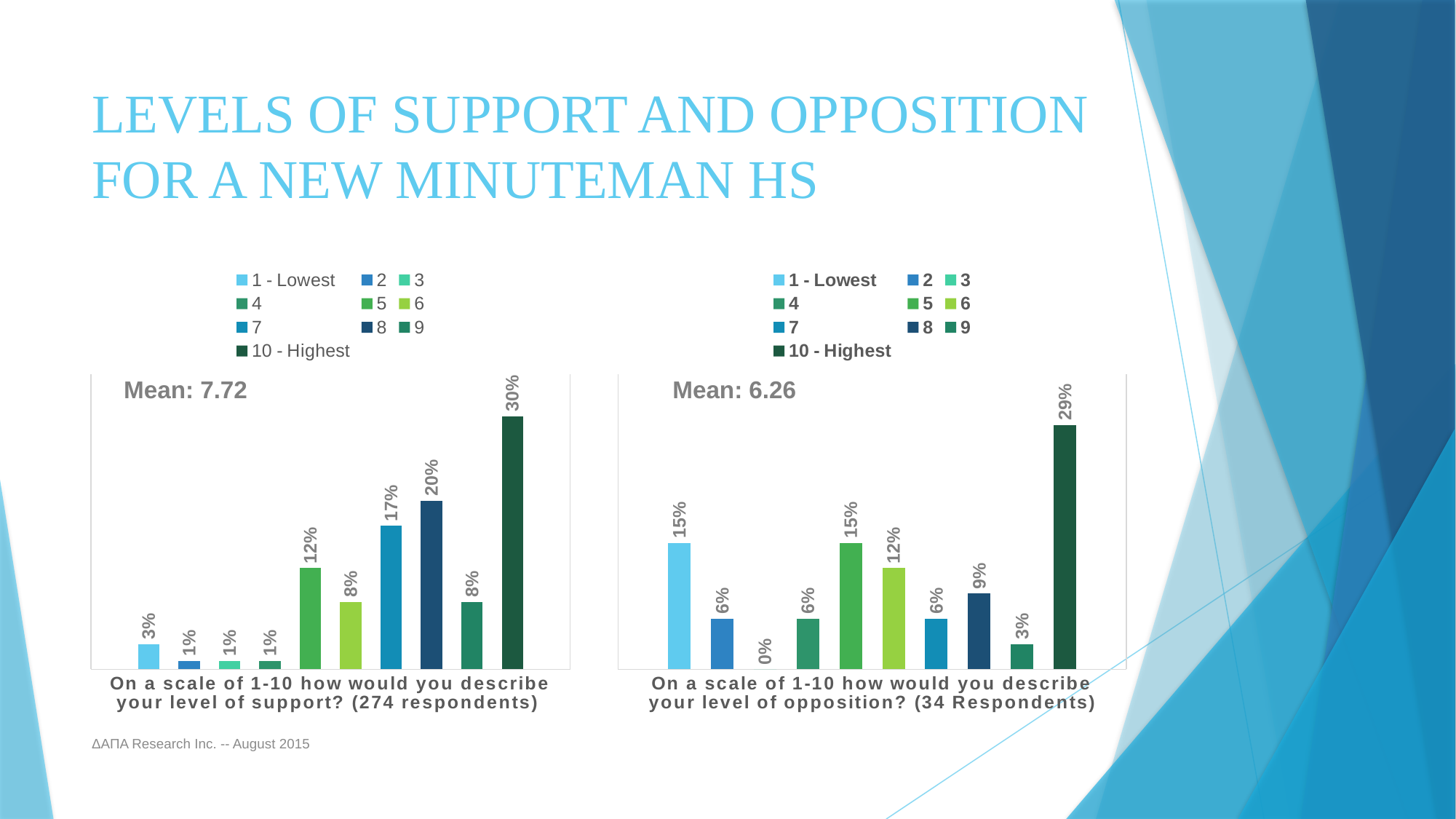
In the right chart (level of opposition), which is larger: the percentage for rating 6 or the percentage for rating 8? 6 In the left chart (level of support), what percentage of respondents gave a rating of 10 - Highest? 30% How many respondents does the right chart (level of opposition) report? 34 How many series does the legend of the left chart (level of support) list? 10 In the right chart (level of opposition), what is the difference between the percentage for rating 10 - Highest and the percentage for rating 5? 14% In the right chart (level of opposition), which rating has the highest percentage? 10 - Highest In the right chart (level of opposition), what percentage of respondents gave a rating of 1 - Lowest? 15% In the left chart (level of support), what is the difference between the percentage for rating 8 and the percentage for rating 6? 12% What is the mean shown on the left chart (level of support)? 7.72 What kind of chart is the right chart (level of opposition)? Bar chart In the left chart (level of support), what percentage of respondents gave a rating of 7? 17% In the right chart (level of opposition), which rating has the lowest percentage? 3